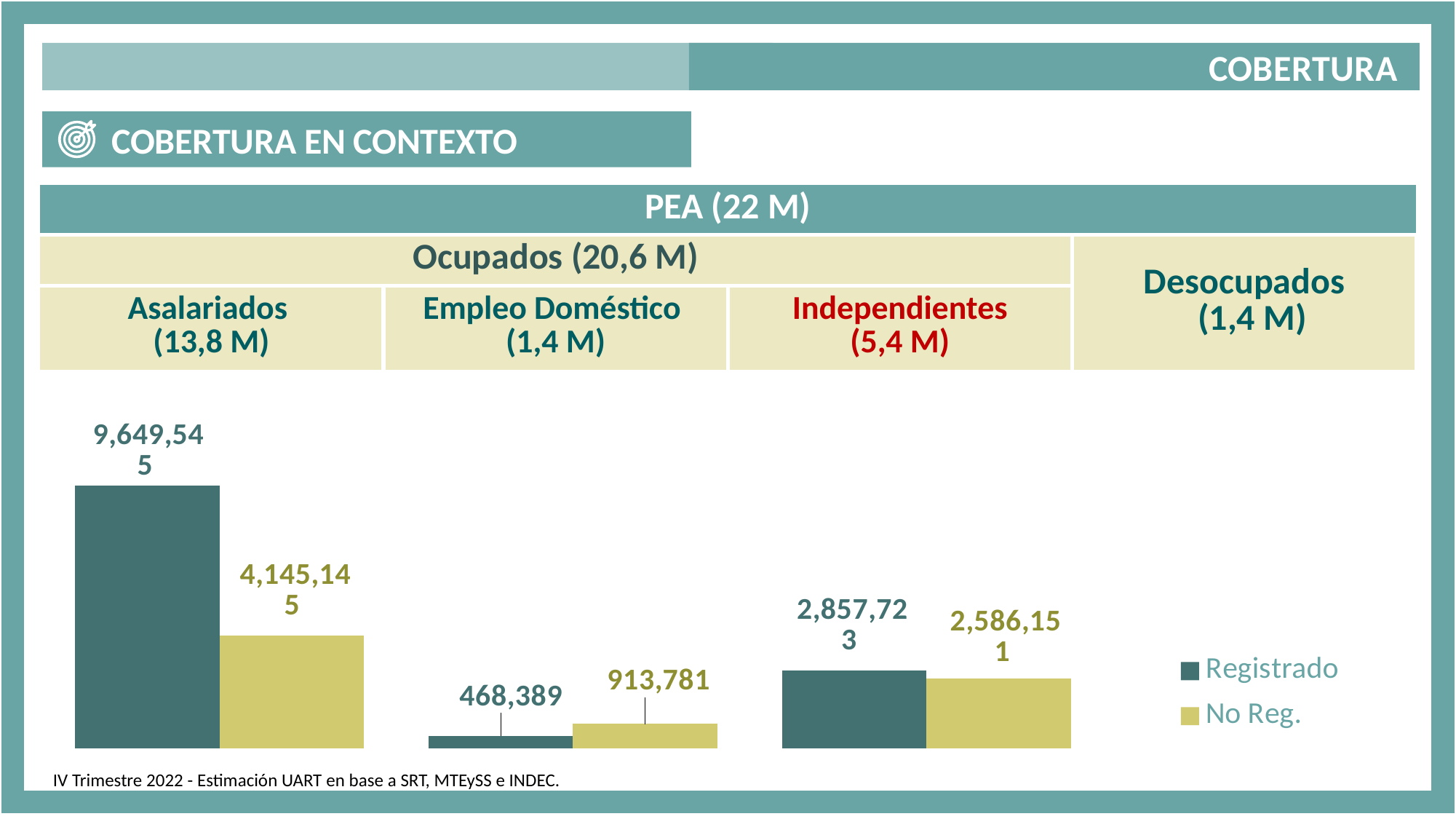
What is the Registrado value for Empleo Doméstico? 468,389 Which category has the highest Registrado value? Asalariados What kind of chart is shown on the slide? Bar chart For Empleo Doméstico, which is larger: Registrado or No Reg.? No Reg. What is the No Reg. value for Asalariados? 4,145,145 What is the No Reg. value for Empleo Doméstico? 913,781 What is the No Reg. value for Independientes? 2,586,151 How many series does the legend list? 2 What is the difference between the Registrado and No Reg. values for Asalariados? 5,504,400 Which category has the lowest No Reg. value? Empleo Doméstico What is the Registrado value for Asalariados? 9,649,545 What is the Registrado value for Independientes? 2,857,723